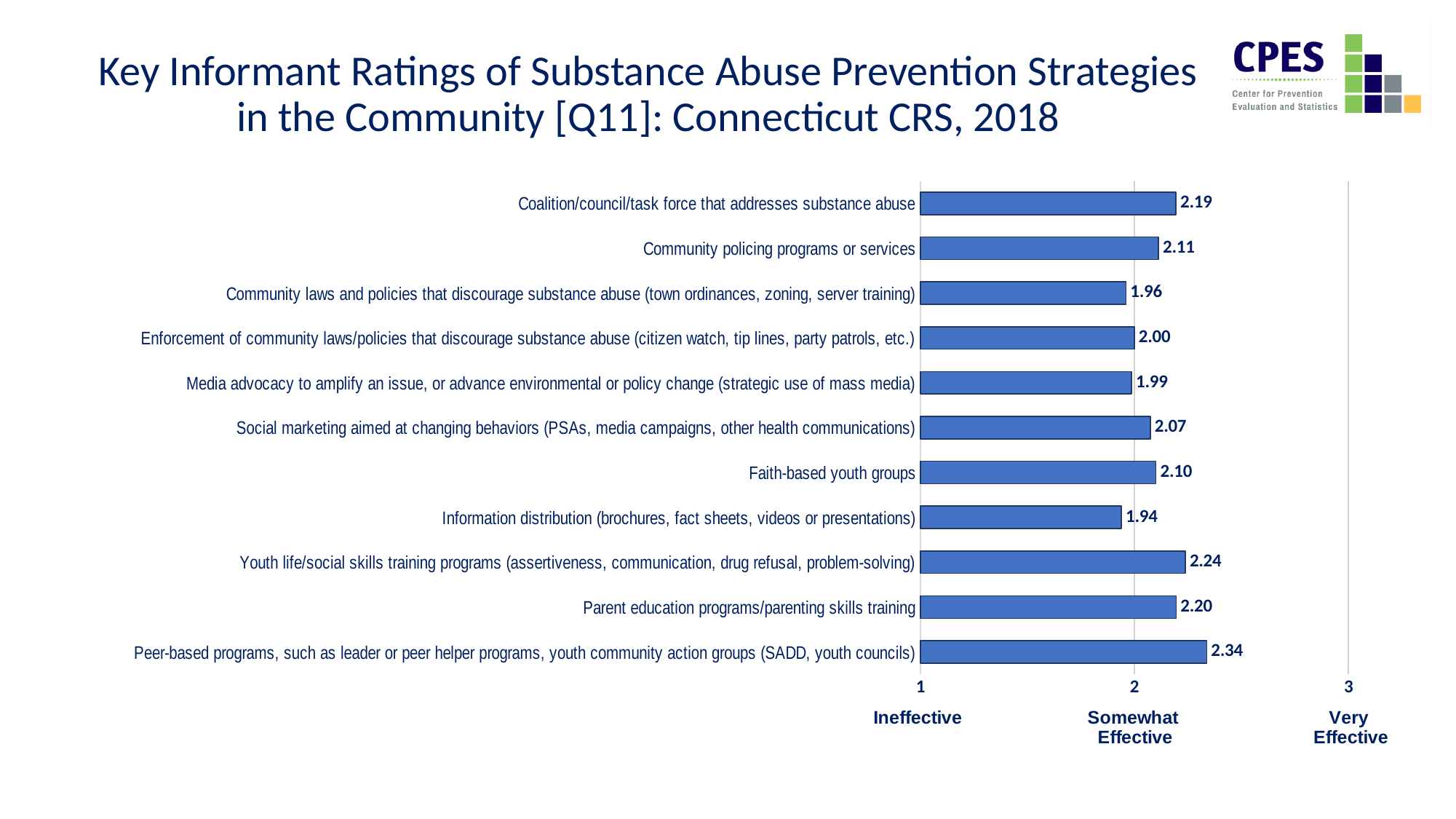
What is the difference between the rating for Coalition/council/task force that addresses substance abuse and the rating for Community policing programs or services? 0.08 Is the rating for Youth life/social skills training programs greater or less than 2? greater Which strategy has the highest rating? Peer-based programs, such as leader or peer helper programs, youth community action groups (SADD, youth councils) What label does the x axis show at the value 3? Very Effective Which strategy has the lowest rating? Information distribution (brochures, fact sheets, videos or presentations) What is the rating for Community policing programs or services? 2.11 How many strategies are rated in the chart? 11 Which has a higher rating: Coalition/council/task force that addresses substance abuse or Community laws and policies that discourage substance abuse? Coalition/council/task force that addresses substance abuse What kind of chart is shown on the slide? Bar chart What is the difference between the rating for Peer-based programs and the rating for Information distribution? 0.40 What is the rating for Faith-based youth groups? 2.10 What is the rating for Parent education programs/parenting skills training? 2.20